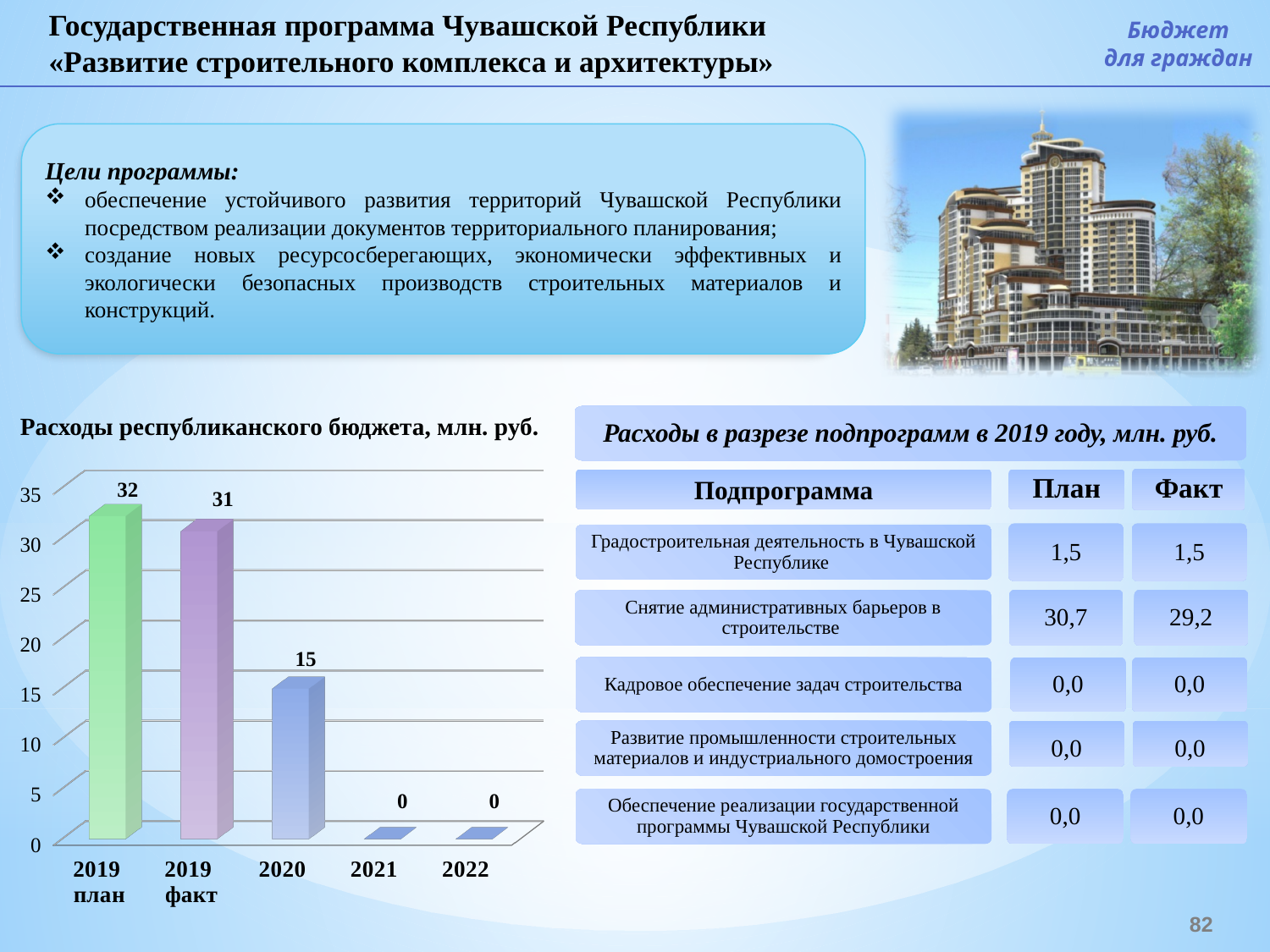
Do the values in the chart 'Расходы республиканского бюджета, млн. руб.' rise or fall from 2019 план to 2022? fall Is the value for 2020 in the chart 'Расходы республиканского бюджета, млн. руб.' greater or less than 20? less Which category has the highest value in the chart 'Расходы республиканского бюджета, млн. руб.'? 2019 план How many categories are shown on the x axis of the chart 'Расходы республиканского бюджета, млн. руб.'? 5 What is the value for 2020 in the chart 'Расходы республиканского бюджета, млн. руб.'? 15 What kind of chart is 'Расходы республиканского бюджета, млн. руб.'? bar chart What is the value for 2019 план in the chart 'Расходы республиканского бюджета, млн. руб.'? 32 What is the value for 2019 факт in the chart 'Расходы республиканского бюджета, млн. руб.'? 31 Which is larger in the chart 'Расходы республиканского бюджета, млн. руб.': the value for 2020 or the value for 2022? 2020 What is the difference between the values for 2019 факт and 2020 in the chart 'Расходы республиканского бюджета, млн. руб.'? 16 What is the difference between the values for 2019 план and 2019 факт in the chart 'Расходы республиканского бюджета, млн. руб.'? 1 What is the value for 2021 in the chart 'Расходы республиканского бюджета, млн. руб.'? 0